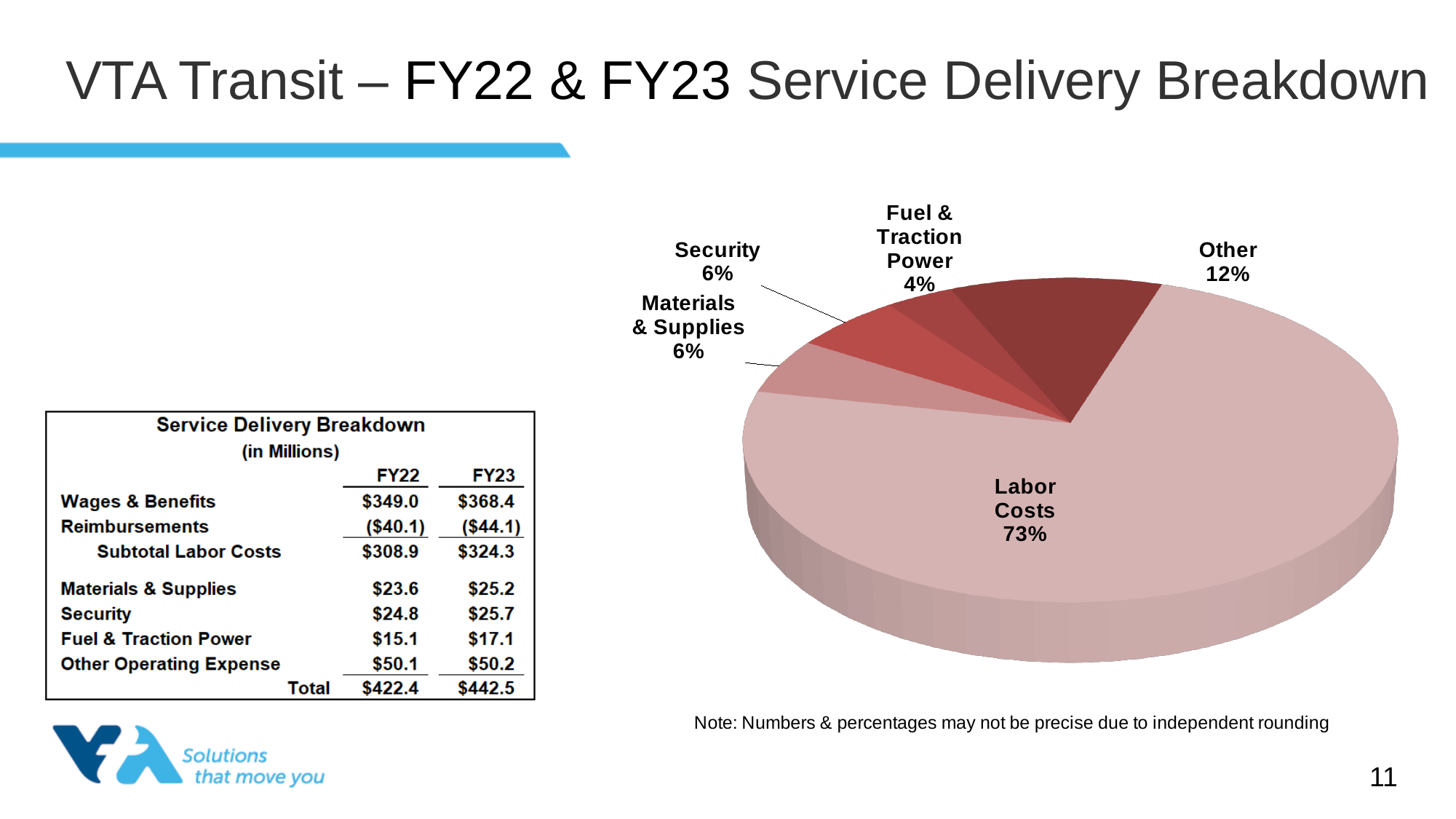
What share of the pie chart is Other? 12% What share of the pie chart is Materials & Supplies? 6% What share of the pie chart is Security? 6% What kind of chart is shown on the slide? Pie chart In the pie chart, which is larger: Other or Security? Other Which slice of the pie chart is the largest? Labor Costs Which slice of the pie chart is the smallest? Fuel & Traction Power How many slices does the pie chart have? 5 What is the difference in percentage points between the Labor Costs slice and the Other slice in the pie chart? 61 What note appears below the pie chart? Note: Numbers & percentages may not be precise due to independent rounding